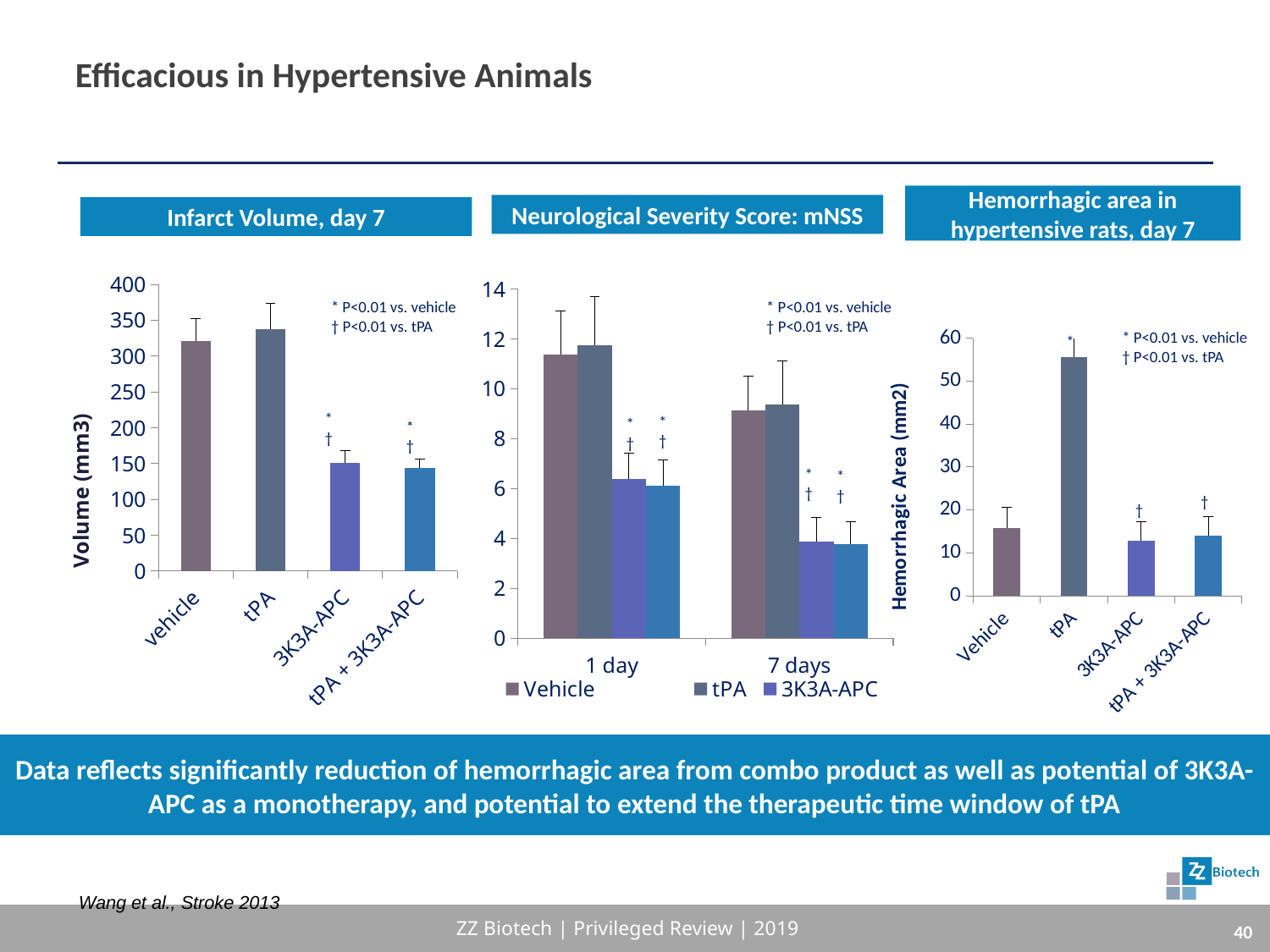
In the Neurological Severity Score: mNSS chart, which is larger, the Vehicle value at 1 day or the Vehicle value at 7 days? 1 day In the Neurological Severity Score: mNSS chart, how many series does the legend list? 3 In the Infarct Volume, day 7 chart, how many categories are shown on the x axis? 4 In the Neurological Severity Score: mNSS chart, is the 3K3A-APC value at 7 days greater or less than 6? less What kind of chart is the Infarct Volume, day 7 chart? bar chart In the Hemorrhagic area in hypertensive rats, day 7 chart, is the value for tPA greater or less than 50? greater In the Neurological Severity Score: mNSS chart, is the Vehicle value at 1 day greater or less than 10? greater What is the y-axis label of the Hemorrhagic area in hypertensive rats, day 7 chart? Hemorrhagic Area (mm2) In the Hemorrhagic area in hypertensive rats, day 7 chart, which category has the highest value? tPA In the Infarct Volume, day 7 chart, which is larger, the value for tPA or the value for 3K3A-APC? tPA